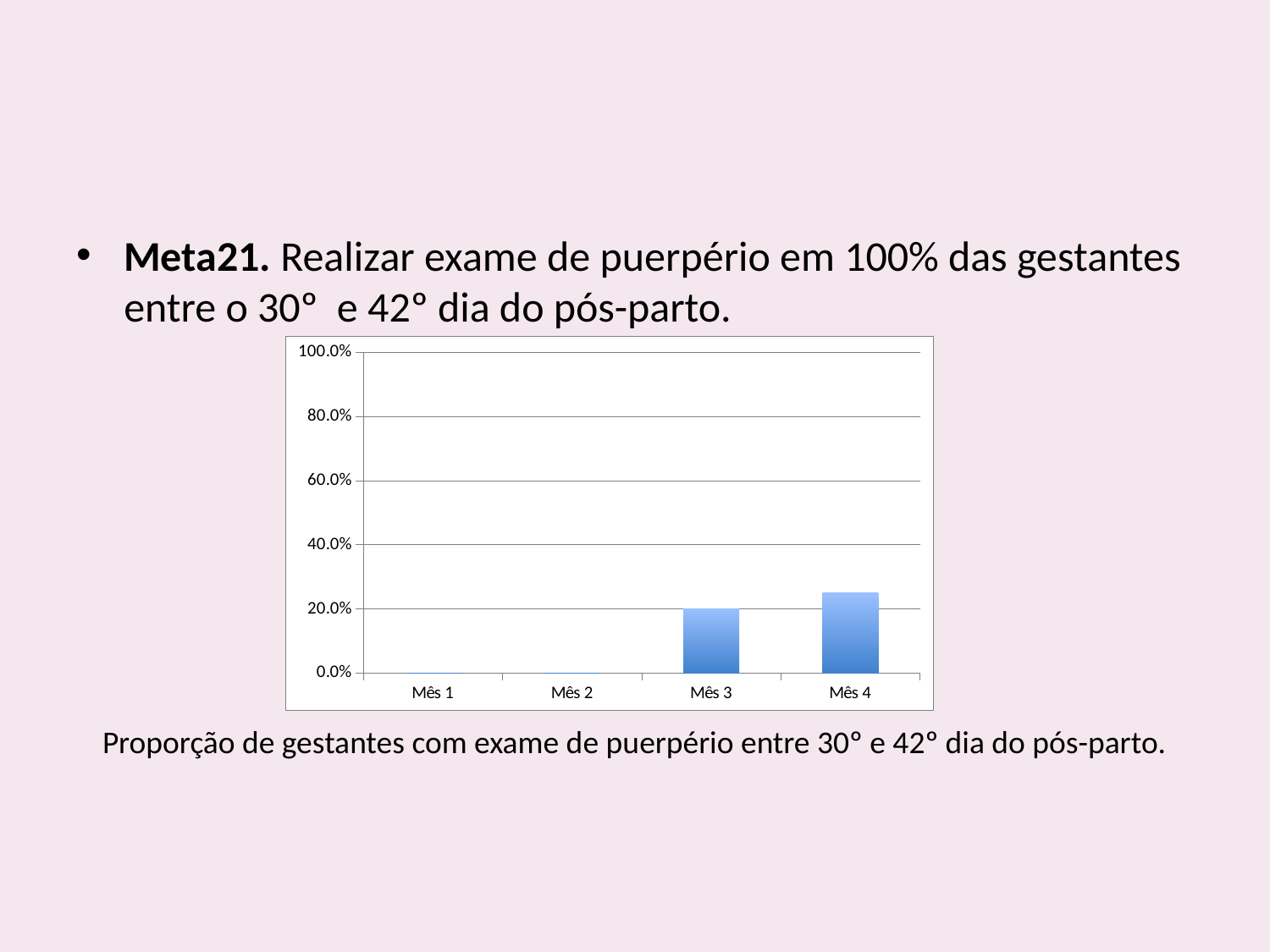
Which month has the highest value in the chart? Mês 4 What is the value for Mês 1 in the chart? 0.0% Do the values rise or fall from Mês 1 to Mês 4? rise How many categories are shown on the x axis of the chart? 4 Is the value for Mês 4 greater or less than 20.0%? greater What is the difference between the values for Mês 3 and Mês 1? 20.0% Which is larger, the value for Mês 3 or the value for Mês 4? Mês 4 What kind of chart is shown on the slide? bar chart What is the highest value shown on the y axis of the chart? 100.0% Is the value for Mês 4 greater or less than 40.0%? less What is the value for Mês 2 in the chart? 0.0% What is the value for Mês 3 in the chart? 20.0%